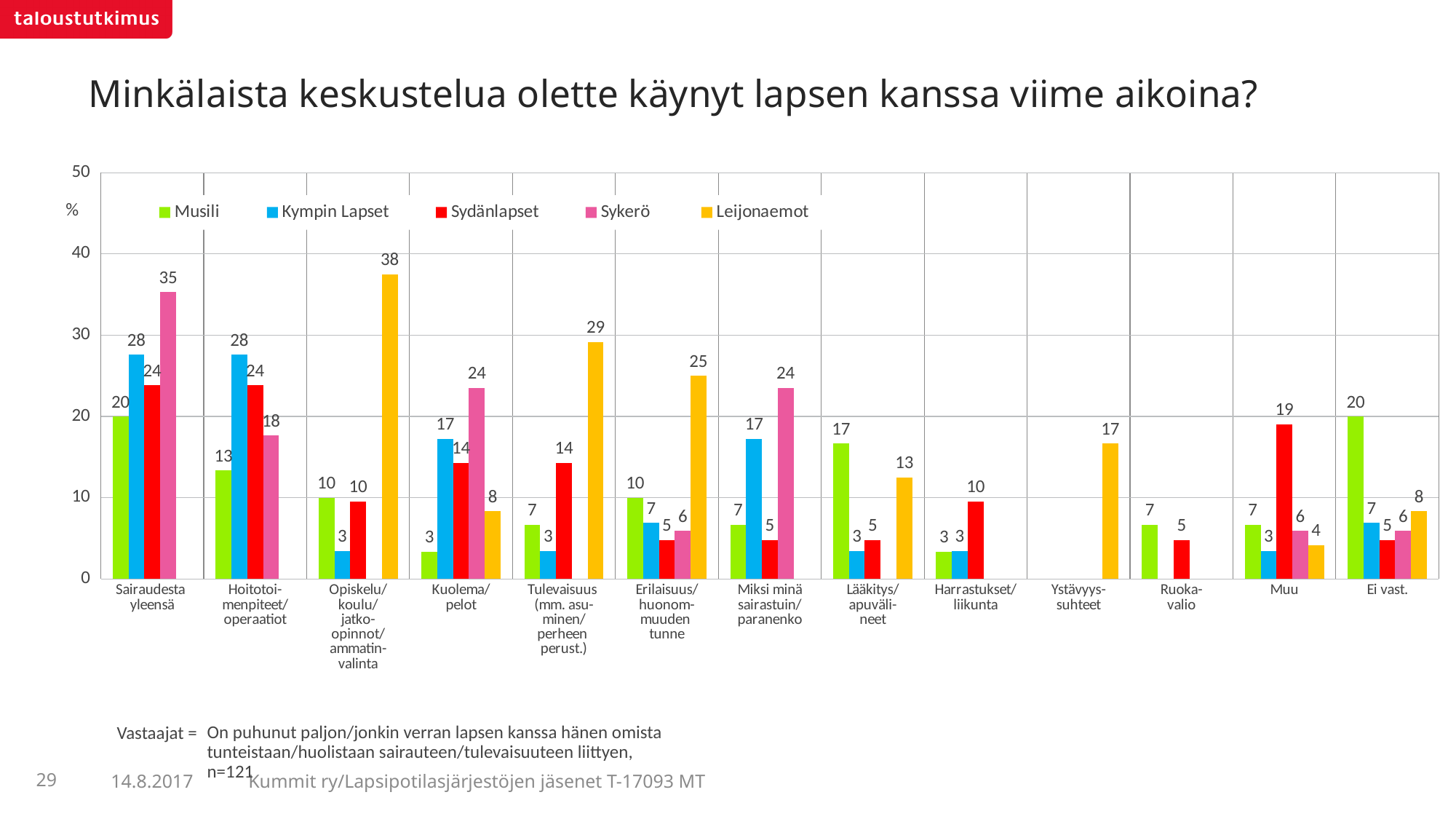
What is the value for Leijonaemot in the Opiskelu/koulu/jatko-opinnot/ammatinvalinta category? 38 How many categories are shown on the x axis? 13 Which series has the highest value in the Tulevaisuus category? Leijonaemot What is the value for Kympin Lapset in the Kuolema/pelot category? 17 What is the value for Sykerö in the Sairaudesta yleensä category? 35 What kind of chart is shown on the slide? Bar chart Which is larger in the Ei vast. category: the Musili value or the Leijonaemot value? Musili What is the value for Sydänlapset in the Muu category? 19 Which series has the lowest value in the Kuolema/pelot category? Musili Is the value for Leijonaemot in the Erilaisuus/huonommuuden tunne category greater or less than 20? greater How many series does the legend list? 5 What is the difference between the Kympin Lapset and Musili values in the Hoitotoimenpiteet/operaatiot category? 15